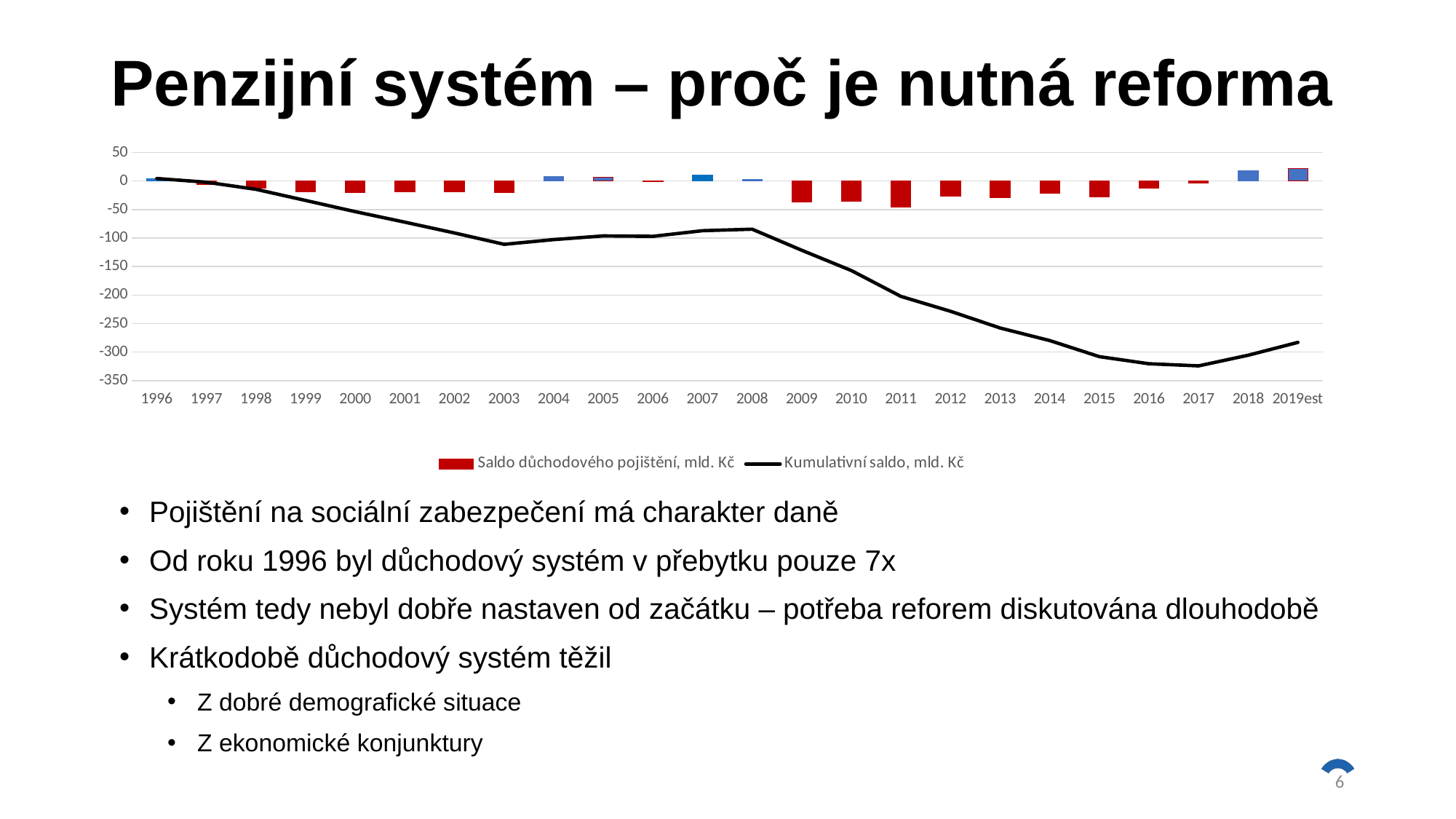
What colour is the line for 'Kumulativní saldo, mld. Kč'? Black Is the value of 'Kumulativní saldo, mld. Kč' in 2017 greater or less than -300? less Which year has the lowest (most negative) bar for 'Saldo důchodového pojištění, mld. Kč'? 2011 Which is larger, the 'Saldo důchodového pojištění, mld. Kč' bar in 2009 or in 2011? 2009 Is the value of 'Kumulativní saldo, mld. Kč' in 2008 greater or less than -100? greater Does the 'Kumulativní saldo, mld. Kč' line rise or fall from 1996 to 2017? It falls Is the value of 'Kumulativní saldo, mld. Kč' in 2003 greater or less than -100? less How many years (categories) are shown on the x axis? 24 What kind of chart is shown on the slide? A combination bar and line chart How many series does the legend list? 2 Which is larger, the 'Kumulativní saldo, mld. Kč' value in 2003 or in 2008? 2008